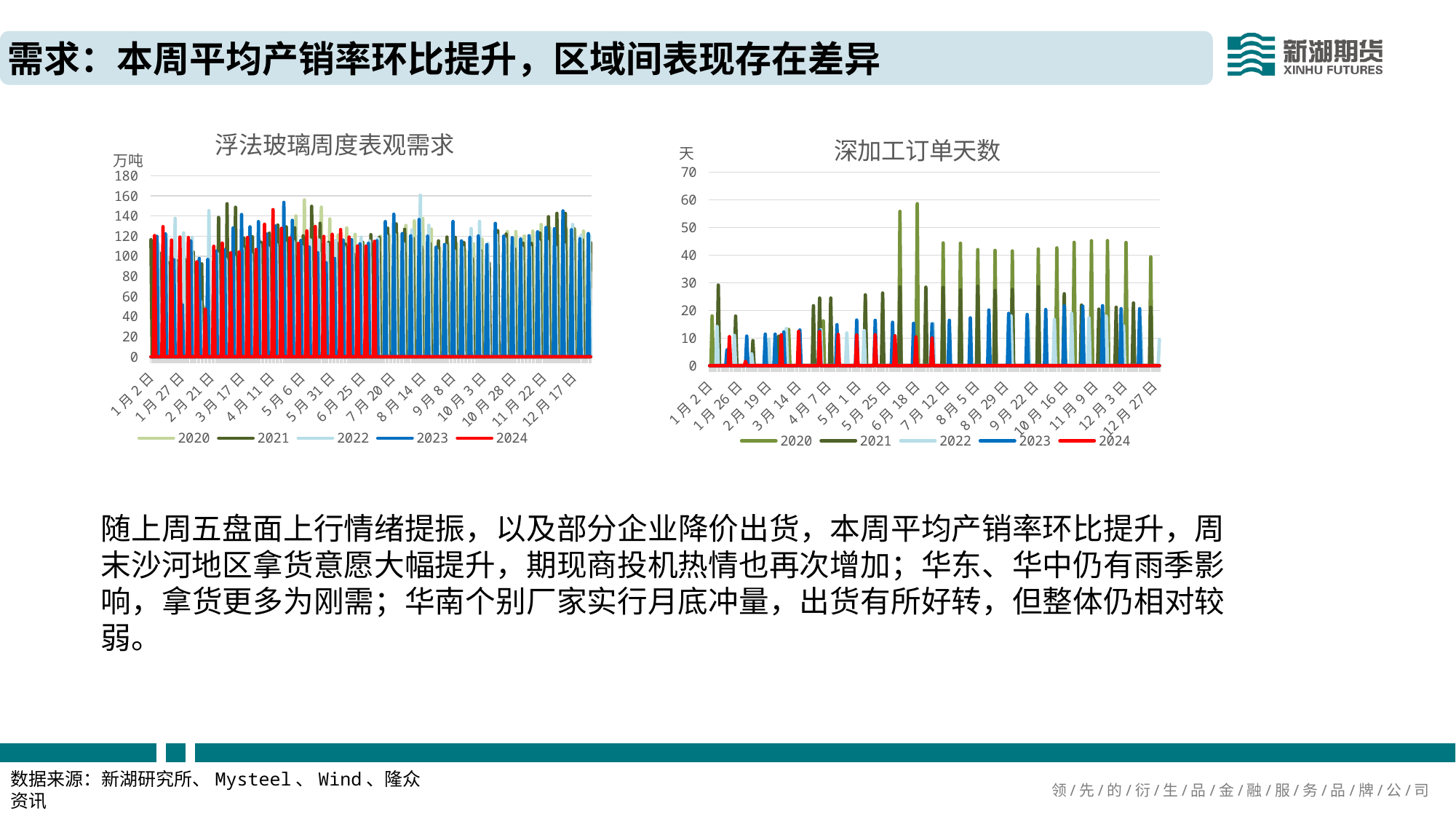
In the right chart (深加工订单天数), which series reaches the highest value on the chart? 2020 What is the title of the chart on the left? 浮法玻璃周度表观需求 How many series does the legend of the right chart (深加工订单天数) list? 5 What kind of chart is the right chart (深加工订单天数)? line chart What is the title of the chart on the right? 深加工订单天数 What kind of chart is the left chart (浮法玻璃周度表观需求)? line chart In the left chart (浮法玻璃周度表观需求), which series is drawn in red? 2024 How many series does the legend of the left chart (浮法玻璃周度表观需求) list? 5 In the right chart (深加工订单天数), is the highest value of the 2024 series greater or less than 20? less In the right chart (深加工订单天数), is the highest value of the 2021 series greater or less than 50? less